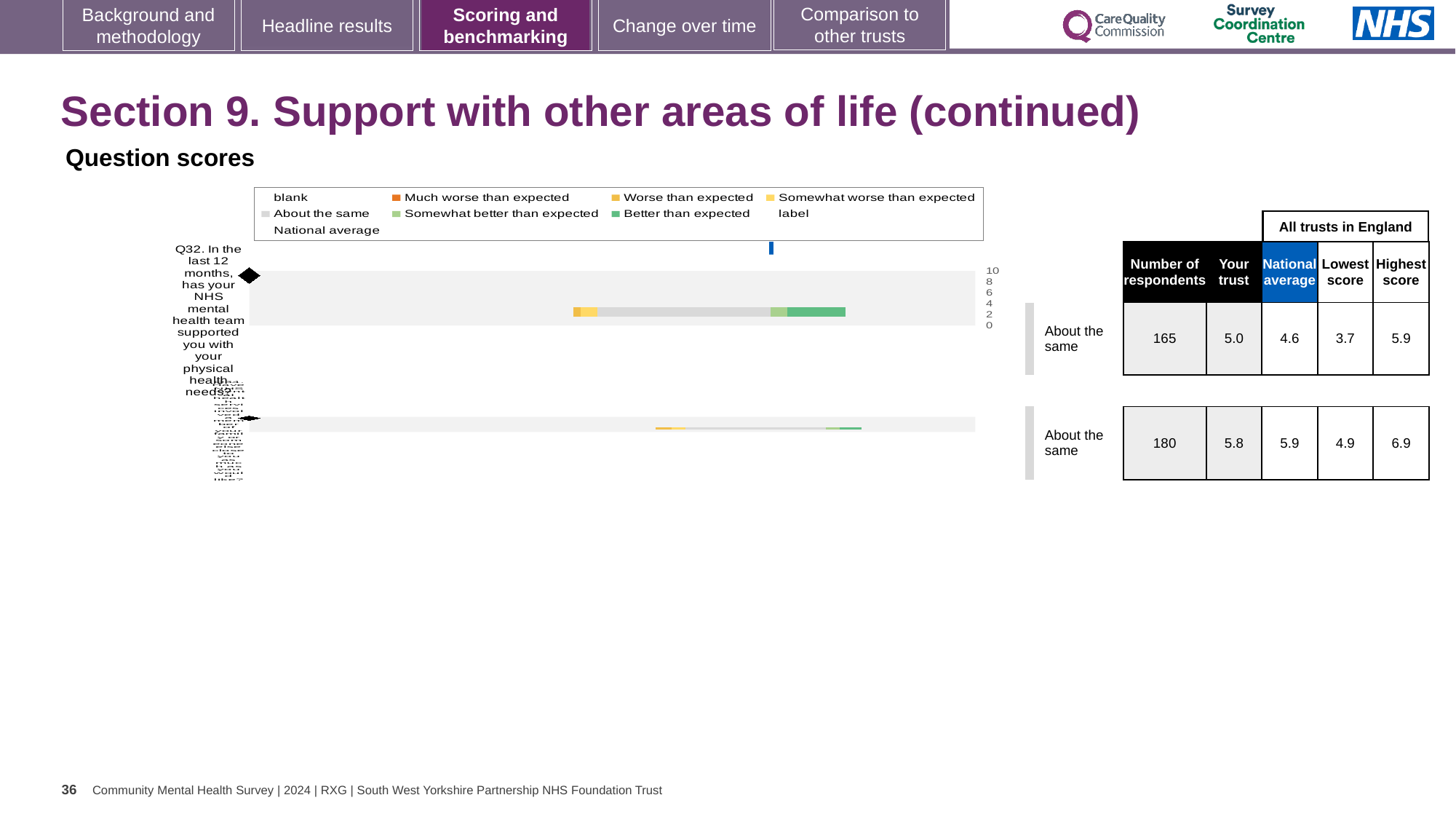
What is the 'Your trust' score for Q32? 5.0 How many question rows are shown in the table? 2 Which legend entry is shown in dark green? Better than expected What is the lowest score among all trusts in England for Q32? 3.7 What is the difference between the highest and lowest scores for Q32? 2.2 What is the national average score for Q32? 4.6 What is the highest score among all trusts in England for Q32? 5.9 For Q32, is the trust's score higher or lower than the national average? higher What benchmark category is shown next to the Q32 bar? About the same How many respondents answered Q32 according to the table? 165 By how much does the trust's score for Q32 exceed the national average? 0.4 What kind of chart is used to show the question scores? bar chart